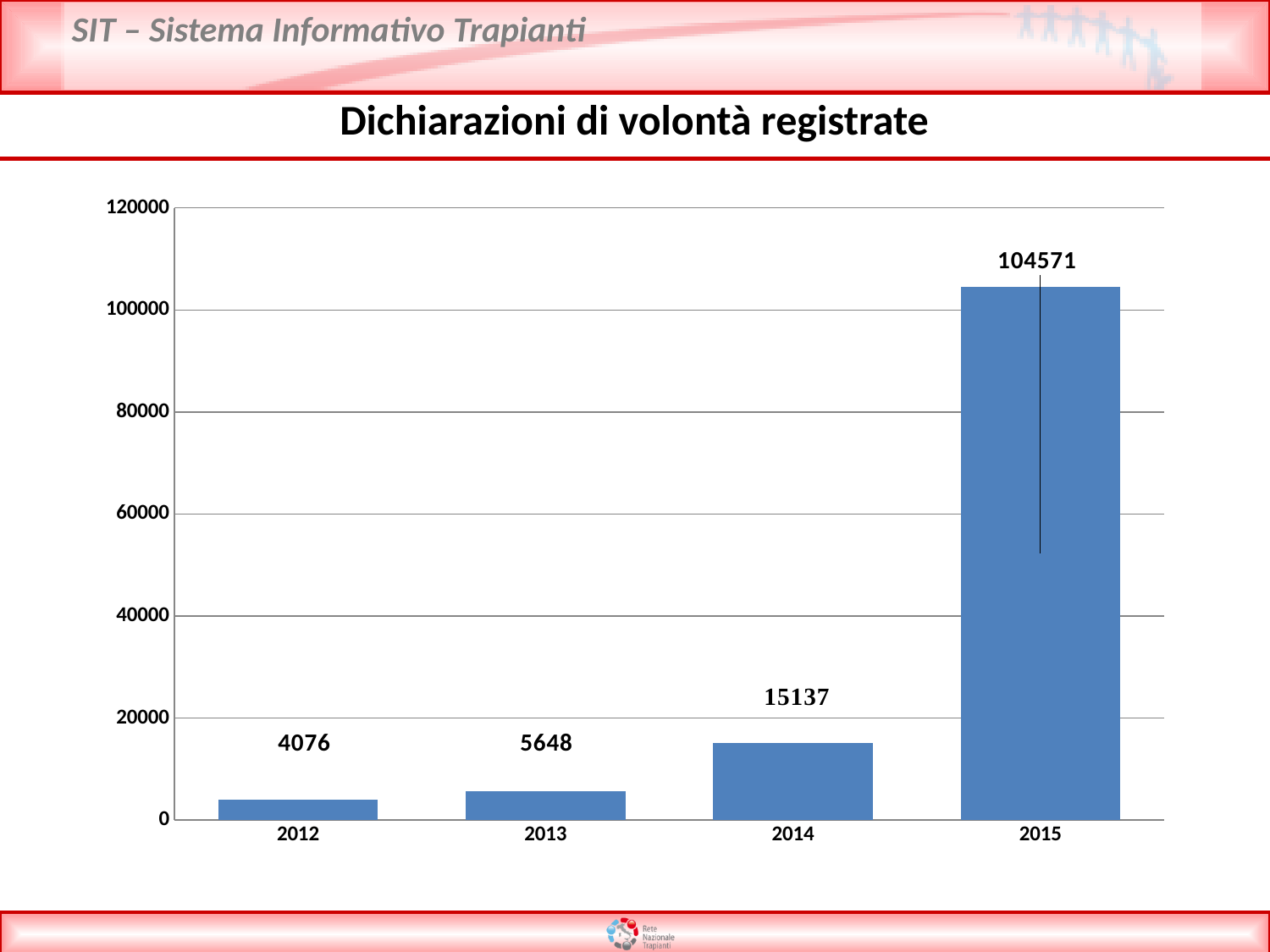
Which is larger, the value for 2014 or the value for 2013? 2014 What is the value for 2015? 104571 Which year has the highest value? 2015 What is the value for 2013? 5648 How many years are shown on the x axis? 4 Which year has the lowest value? 2012 Is the value for 2015 greater or less than 100000? greater What is the difference between the values for 2013 and 2012? 1572 What is the difference between the values for 2015 and 2014? 89434 What kind of chart is shown on the slide? bar chart What is the value for 2014? 15137 What is the value for 2012? 4076